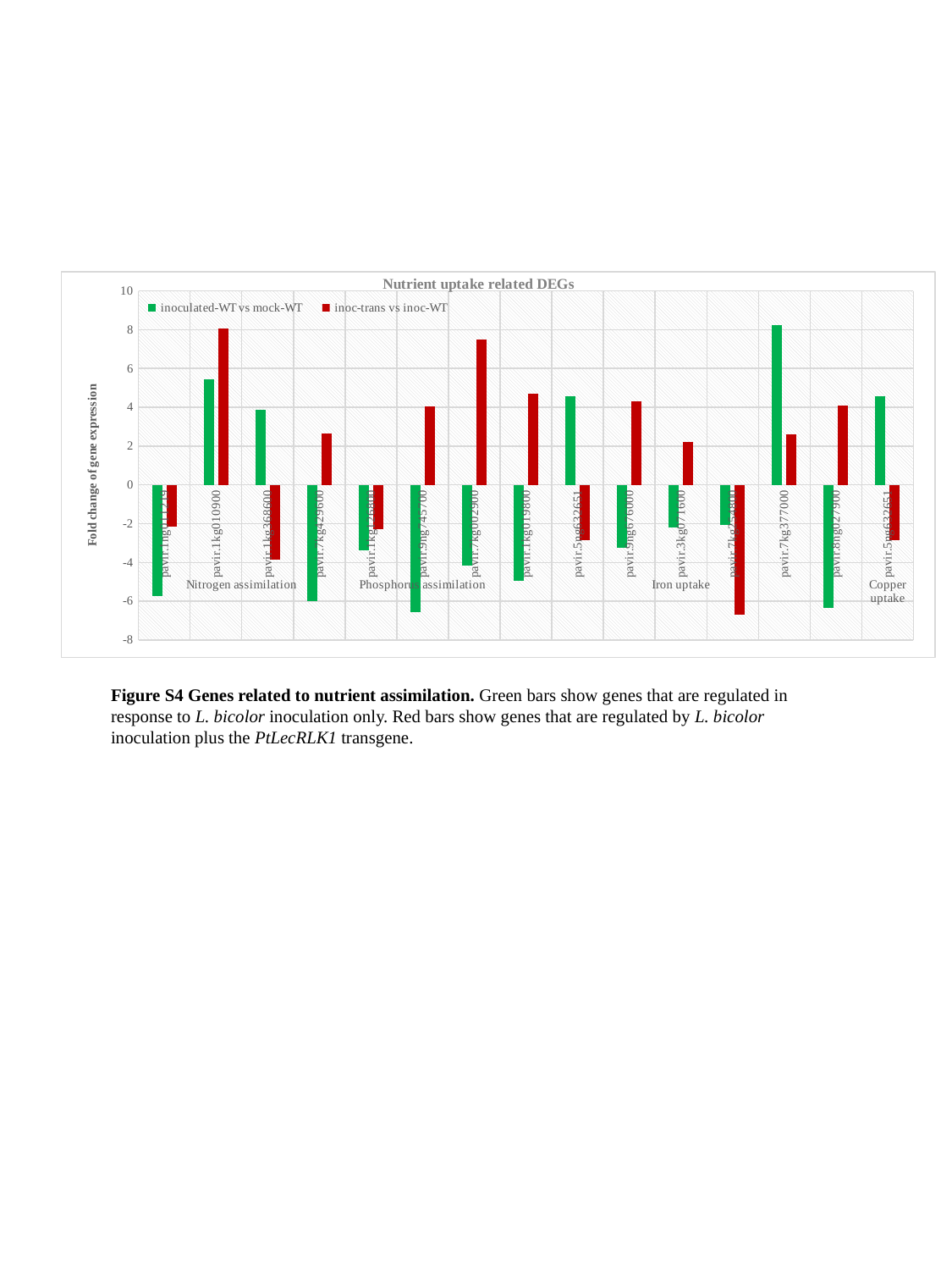
What is the label of the vertical axis? Fold change of gene expression How many genes (categories) are plotted on the x axis? 15 Which gene has the highest value for the inoculated-WT vs mock-WT series? pavir.7kg377000 What is the title of the chart? Nutrient uptake related DEGs Which gene has the highest value for the inoc-trans vs inoc-WT series? pavir.1kg010900 Is the inoc-trans vs inoc-WT value for pavir.7kg002900 greater or less than 6? greater How many series does the legend list? 2 Is the inoculated-WT vs mock-WT value for pavir.1kg019800 greater or less than -4? less Is the inoculated-WT vs mock-WT value for pavir.7kg377000 greater or less than 6? greater For pavir.1kg010900, which series has the larger value: inoculated-WT vs mock-WT or inoc-trans vs inoc-WT? inoc-trans vs inoc-WT For pavir.7kg002900, which series has the larger value: inoculated-WT vs mock-WT or inoc-trans vs inoc-WT? inoc-trans vs inoc-WT What kind of chart is shown on the slide? bar chart